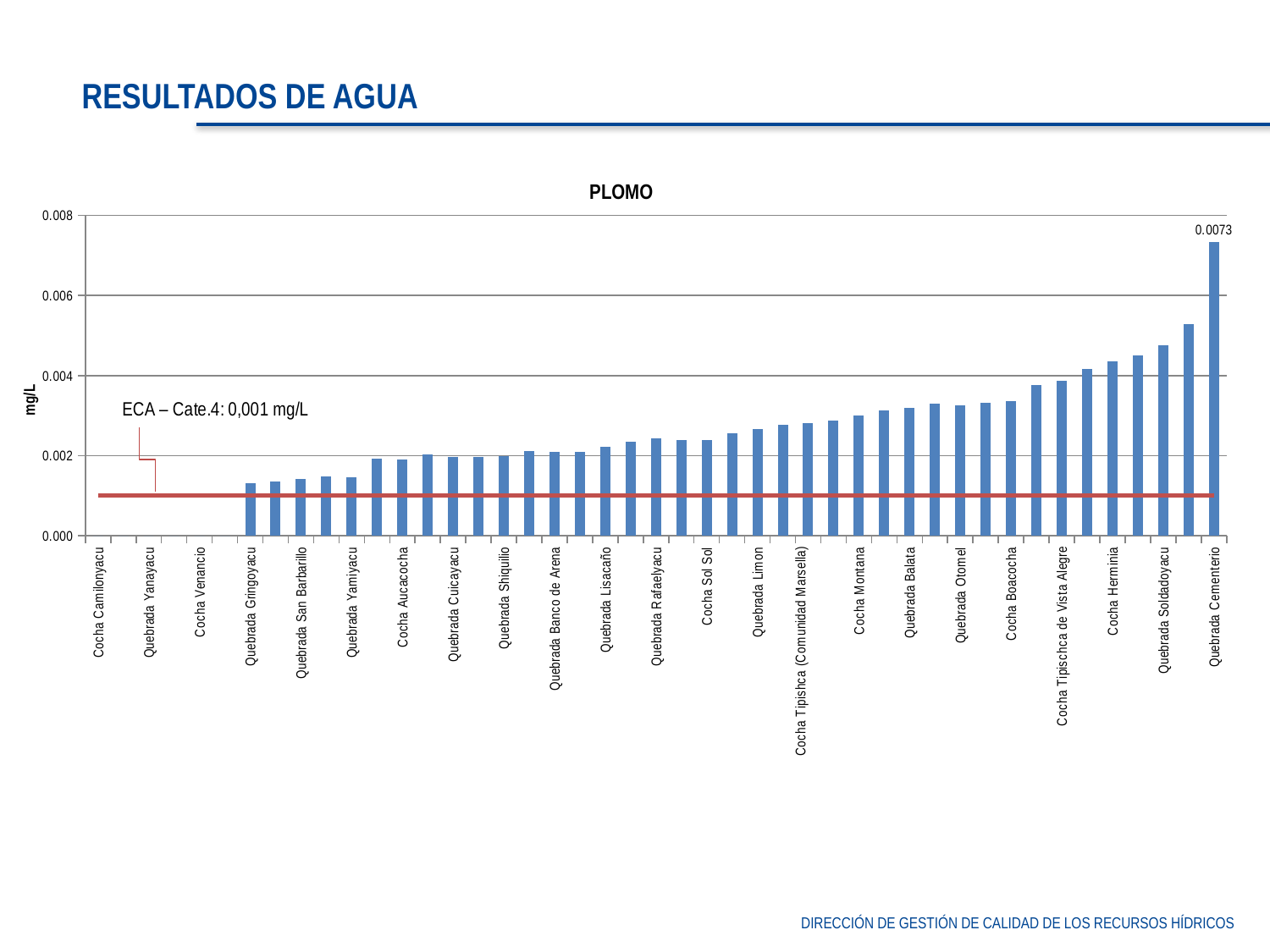
Is the value for Cocha Herminia greater or less than 0.004? greater What is the value shown for Quebrada Cementerio? 0.0073 Is the value for Quebrada Soldadoyacu greater or less than 0.004? greater What is the title of the chart? PLOMO Which category has the highest value in the PLOMO chart? Quebrada Cementerio Is the value for Quebrada Gringoyacu greater or less than 0.002? less Which is larger, the value for Quebrada Soldadoyacu or the value for Quebrada Gringoyacu? Quebrada Soldadoyacu What kind of chart is shown on the slide? bar chart Do the bar values rise or fall from left to right along the x axis? rise What value does the ECA – Cate.4 reference line on the chart represent? 0,001 mg/L